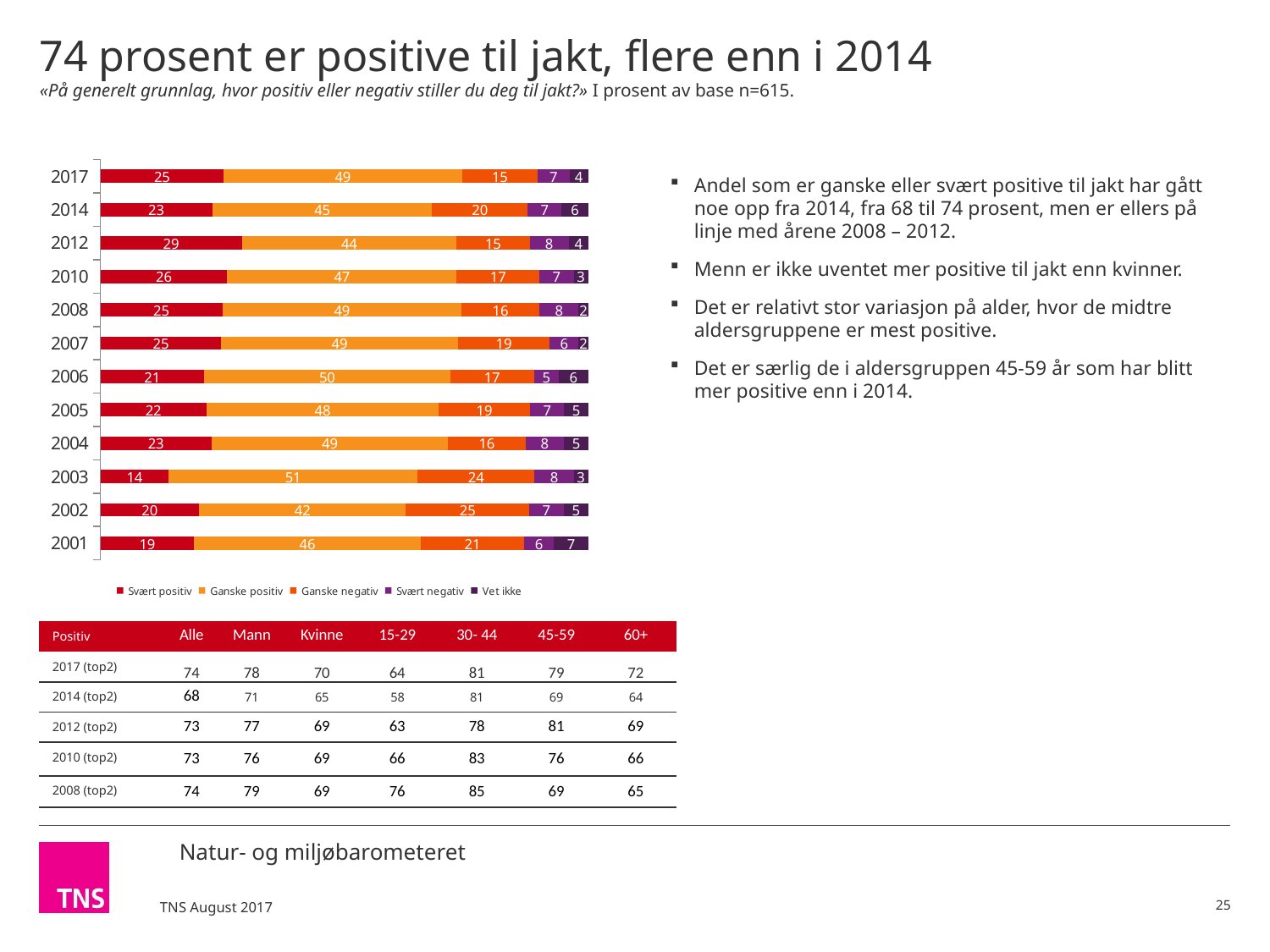
What kind of chart is shown on the slide? Stacked bar chart Which year has the highest value for Svært positiv? 2012 What is the value for Svært positiv in 2017? 25 Which year has the lowest value for Svært positiv? 2003 How many series does the legend list? 5 Which is larger, the Svært positiv value for 2010 or for 2014? 2010 What is the value for Ganske negativ in 2003? 24 What is the difference between the Ganske negativ values for 2014 and 2017? 5 What is the value for Ganske positiv in 2014? 45 How many years are shown in the chart? 12 Which year has the highest value for Ganske positiv? 2003 What is the total of the stacked bar for 2017? 100